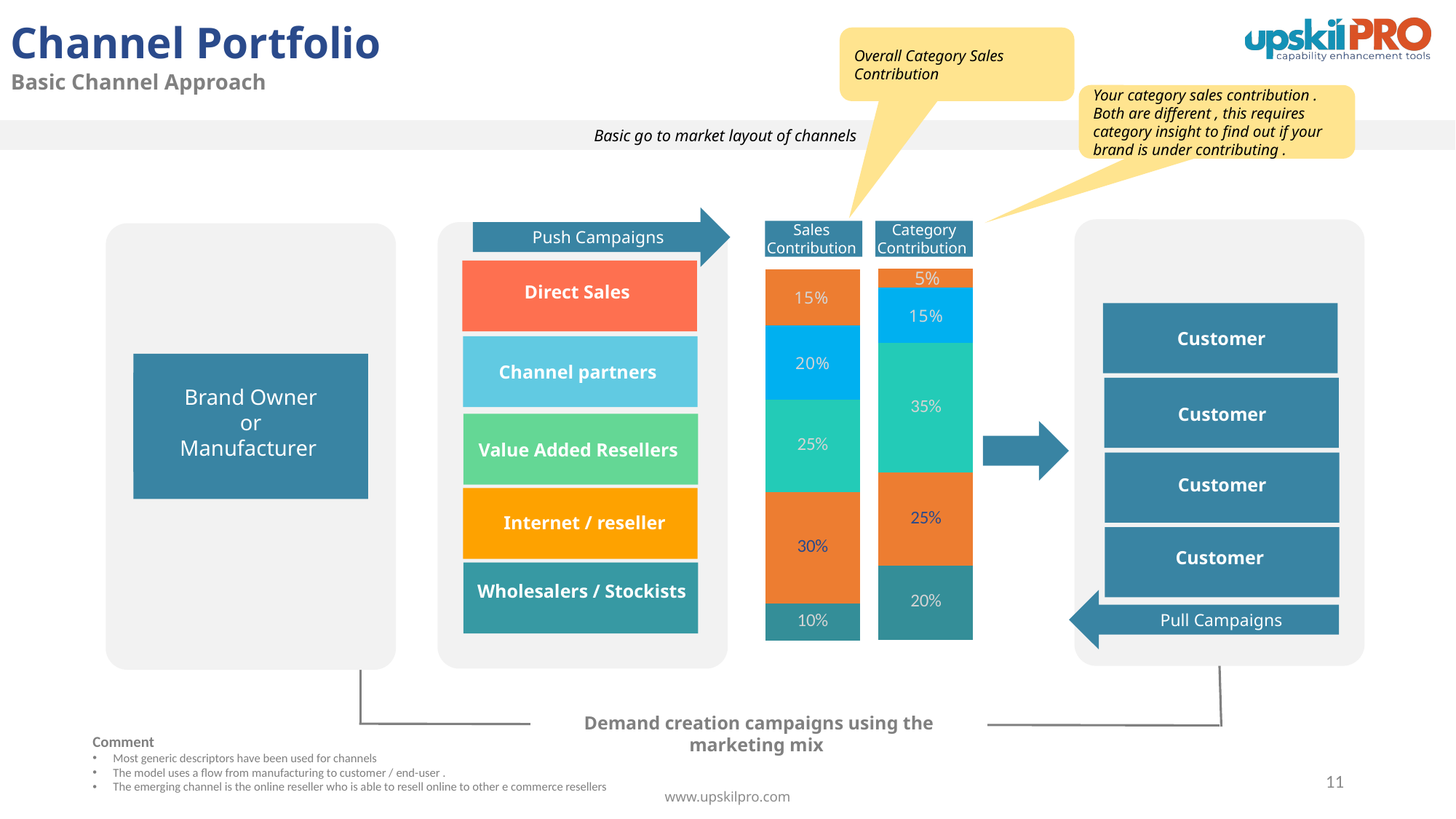
What is the difference between the top segment of the Sales Contribution bar and the top segment of the Category Contribution bar? 10 percentage points How many segments does the Sales Contribution bar contain? 5 What is the smallest segment value in the Category Contribution bar? 5% What is the largest segment value in the Category Contribution bar? 35% In the Category Contribution bar, what is the value of the top segment? 5% What is the largest segment value in the Sales Contribution bar? 30% What kind of chart is used to show the Sales Contribution and Category Contribution? Stacked bar chart In the Sales Contribution bar, what is the value of the top segment? 15% In the Category Contribution bar, what is the value of the bottom segment? 20% In the Sales Contribution bar, what is the value of the bottom segment? 10% Which bar has the larger bottom segment, Sales Contribution or Category Contribution? Category Contribution What is the total of all segments in the Sales Contribution bar? 100%